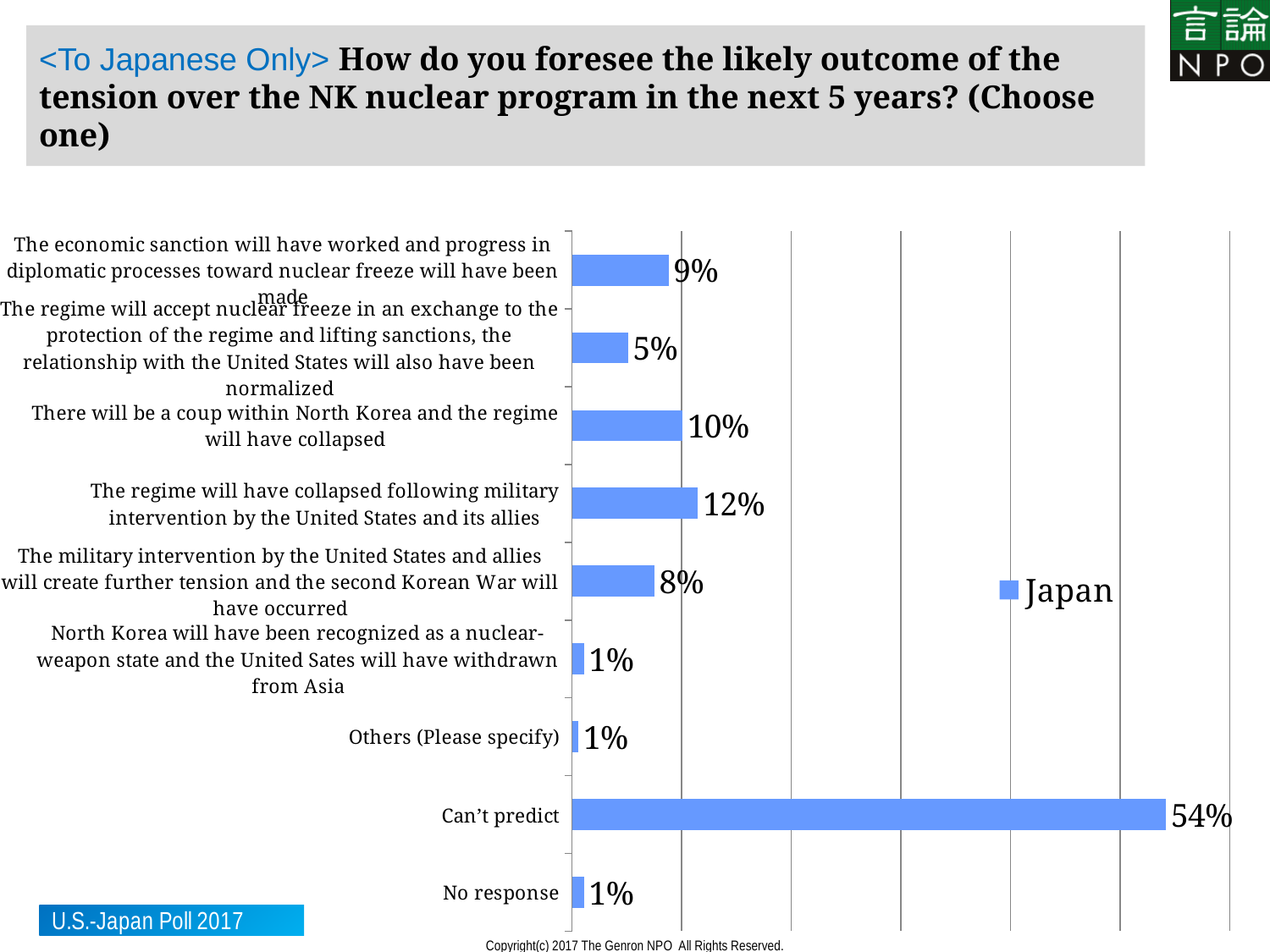
How many series does the legend list? 1 What is the difference between the share for the coup scenario (10%) and the share for the second Korean War scenario? 2% Which is larger: the share for the economic sanction working (nuclear freeze progress) or the share for the regime accepting a nuclear freeze in exchange for protection and lifting sanctions? The economic sanction will have worked and progress in diplomatic processes toward nuclear freeze will have been made What type of chart is shown on the slide? Bar chart What percentage chose "There will be a coup within North Korea and the regime will have collapsed"? 10% What percentage chose "The regime will have collapsed following military intervention by the United States and its allies"? 12% Which response option has the highest percentage? Can't predict How many response categories are shown in the chart? 9 What percentage chose "Others (Please specify)"? 1% What percentage of Japanese respondents answered "Can't predict"? 54% What series name appears in the chart legend? Japan What is the difference between the "Can't predict" share and the share for "The regime will have collapsed following military intervention by the United States and its allies"? 42%